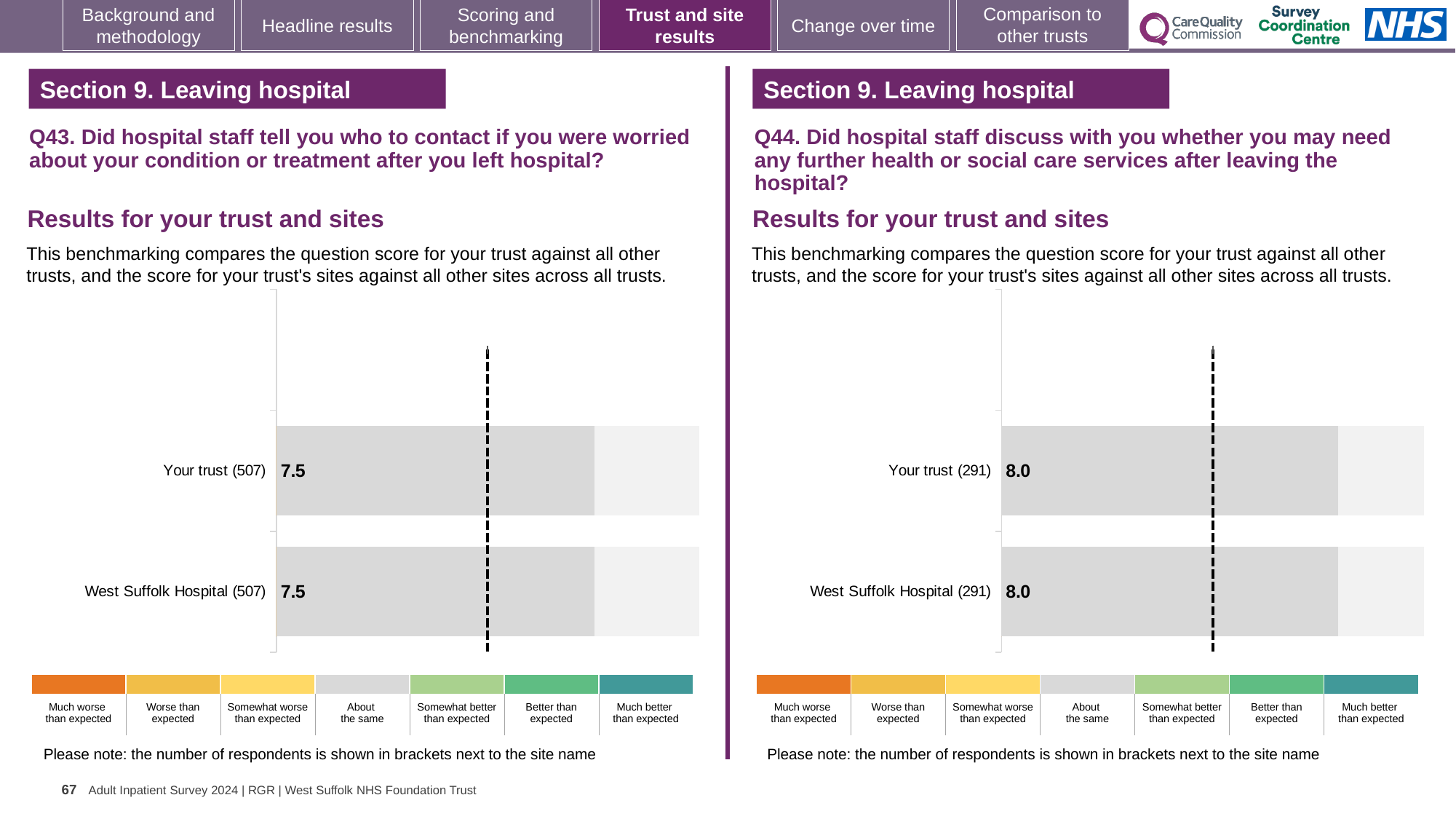
How many bars are plotted in the Q44 chart on the right? 2 In the Q43 chart on the left, how many respondents are shown in brackets next to Your trust? 507 In the Q43 chart on the left, what is the score for West Suffolk Hospital? 7.5 In the Q44 chart on the right, what is the score for West Suffolk Hospital? 8.0 In the Q43 chart on the left, what is the difference between the score for Your trust and the score for West Suffolk Hospital? 0.0 In the Q44 chart on the right, what is the score for Your trust? 8.0 How many bars are plotted in the Q43 chart on the left? 2 What kind of chart is used in the Q43 chart on the left? Bar chart In the Q44 chart on the right, what is the difference between the score for Your trust and the score for West Suffolk Hospital? 0.0 Is the score for Your trust in the Q44 chart on the right larger than the score for Your trust in the Q43 chart on the left? Yes In the Q44 chart on the right, how many respondents are shown in brackets next to West Suffolk Hospital? 291 In the Q43 chart on the left, what is the score for Your trust? 7.5